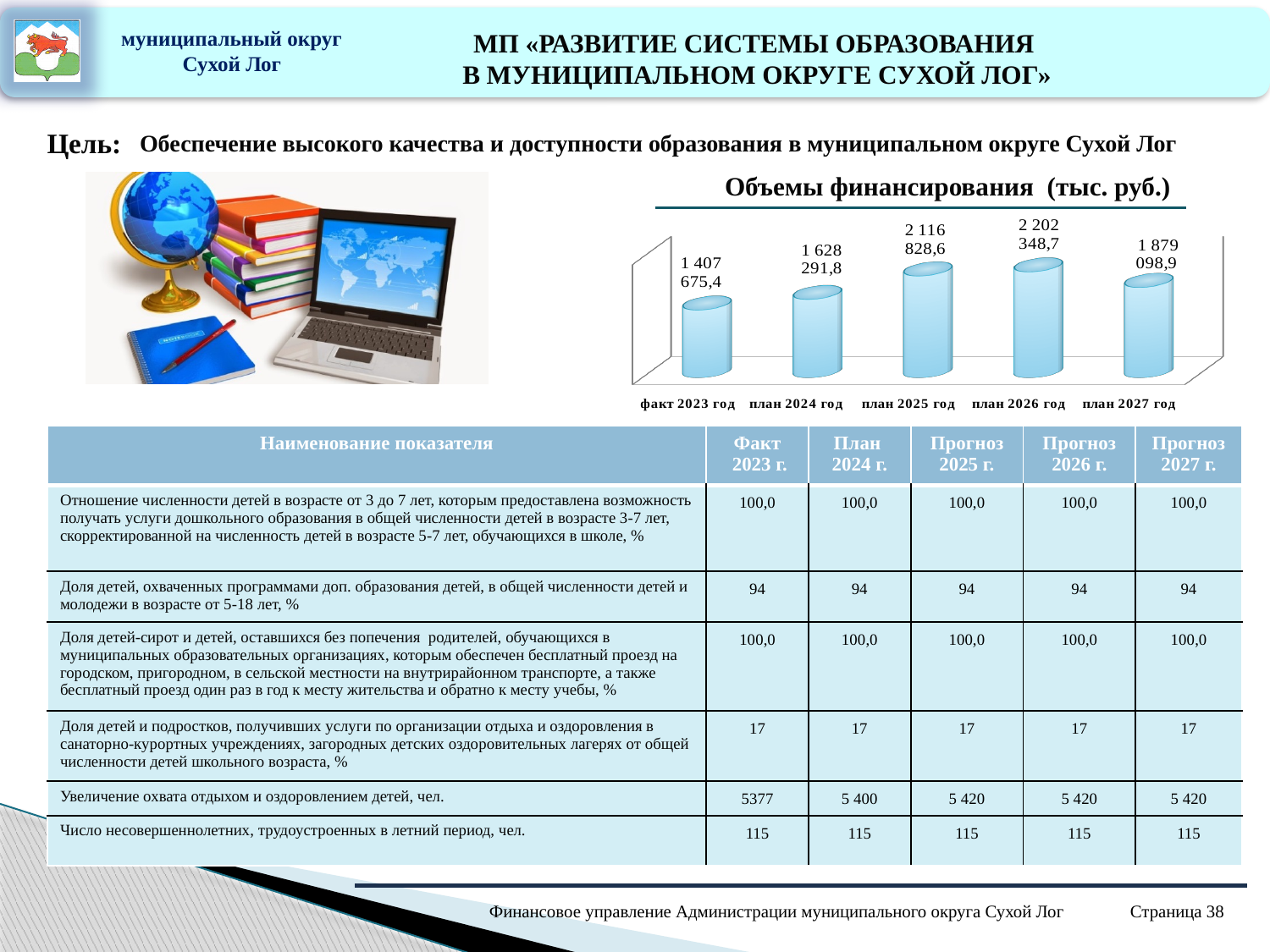
What kind of chart is 'Объемы финансирования (тыс. руб.)'? bar chart What is the value for факт 2023 год in the chart 'Объемы финансирования (тыс. руб.)'? 1 407 675,4 What is the value for план 2025 год in the chart 'Объемы финансирования (тыс. руб.)'? 2 116 828,6 In the chart 'Объемы финансирования (тыс. руб.)', what is the difference between план 2025 год and план 2024 год? 488 536,8 In the chart 'Объемы финансирования (тыс. руб.)', do the values rise or fall from факт 2023 год to план 2026 год? rise Which category has the highest value in the chart 'Объемы финансирования (тыс. руб.)'? план 2026 год In the chart 'Объемы финансирования (тыс. руб.)', what is the difference between план 2026 год and факт 2023 год? 794 673,3 Which category has the lowest value in the chart 'Объемы финансирования (тыс. руб.)'? факт 2023 год How many categories are shown in the chart 'Объемы финансирования (тыс. руб.)'? 5 In the chart 'Объемы финансирования (тыс. руб.)', which is larger: план 2027 год or план 2024 год? план 2027 год What is the value for план 2027 год in the chart 'Объемы финансирования (тыс. руб.)'? 1 879 098,9 What is the value for план 2024 год in the chart 'Объемы финансирования (тыс. руб.)'? 1 628 291,8